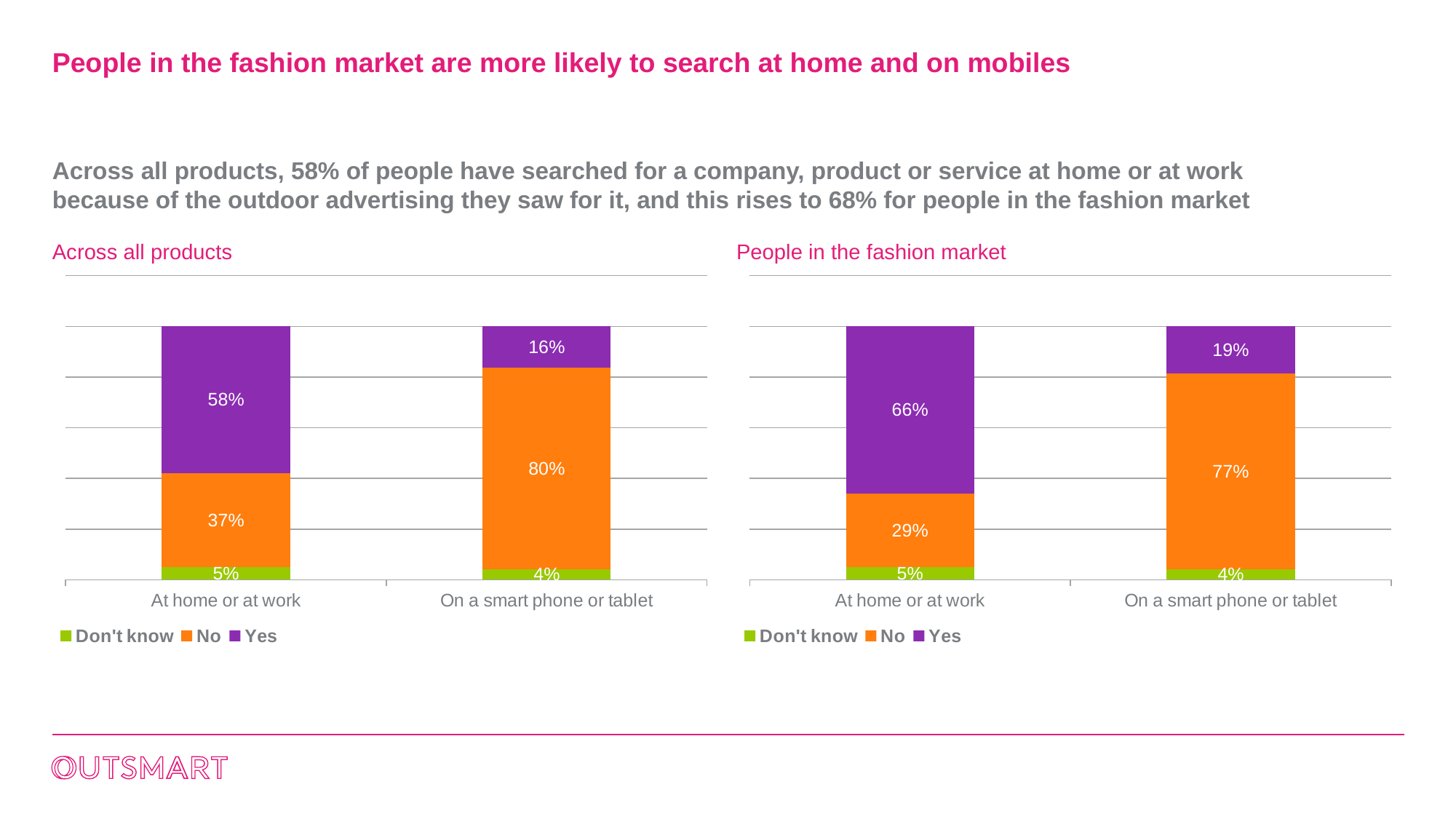
In the 'Across all products' chart, what is the 'Don't know' value for 'On a smart phone or tablet'? 4% How many series does the legend of the 'Across all products' chart list? 3 In the 'Across all products' chart, what is the difference between the 'No' values for 'On a smart phone or tablet' and 'At home or at work'? 43% In the 'Across all products' chart, which category has the higher 'Yes' value? At home or at work In the 'People in the fashion market' chart, what is the 'No' value for 'On a smart phone or tablet'? 77% In the 'Across all products' chart, what is the 'Yes' value for 'At home or at work'? 58% What kind of chart is the 'Across all products' chart? Stacked bar chart In the 'People in the fashion market' chart, which colour represents the 'Yes' series? Purple How many categories are shown on the x axis of the 'People in the fashion market' chart? 2 In the 'People in the fashion market' chart, which category has the lower 'No' value? At home or at work Is the 'Yes' value for 'On a smart phone or tablet' larger in the 'Across all products' chart or the 'People in the fashion market' chart? People in the fashion market In the 'People in the fashion market' chart, what is the 'Yes' value for 'At home or at work'? 66%